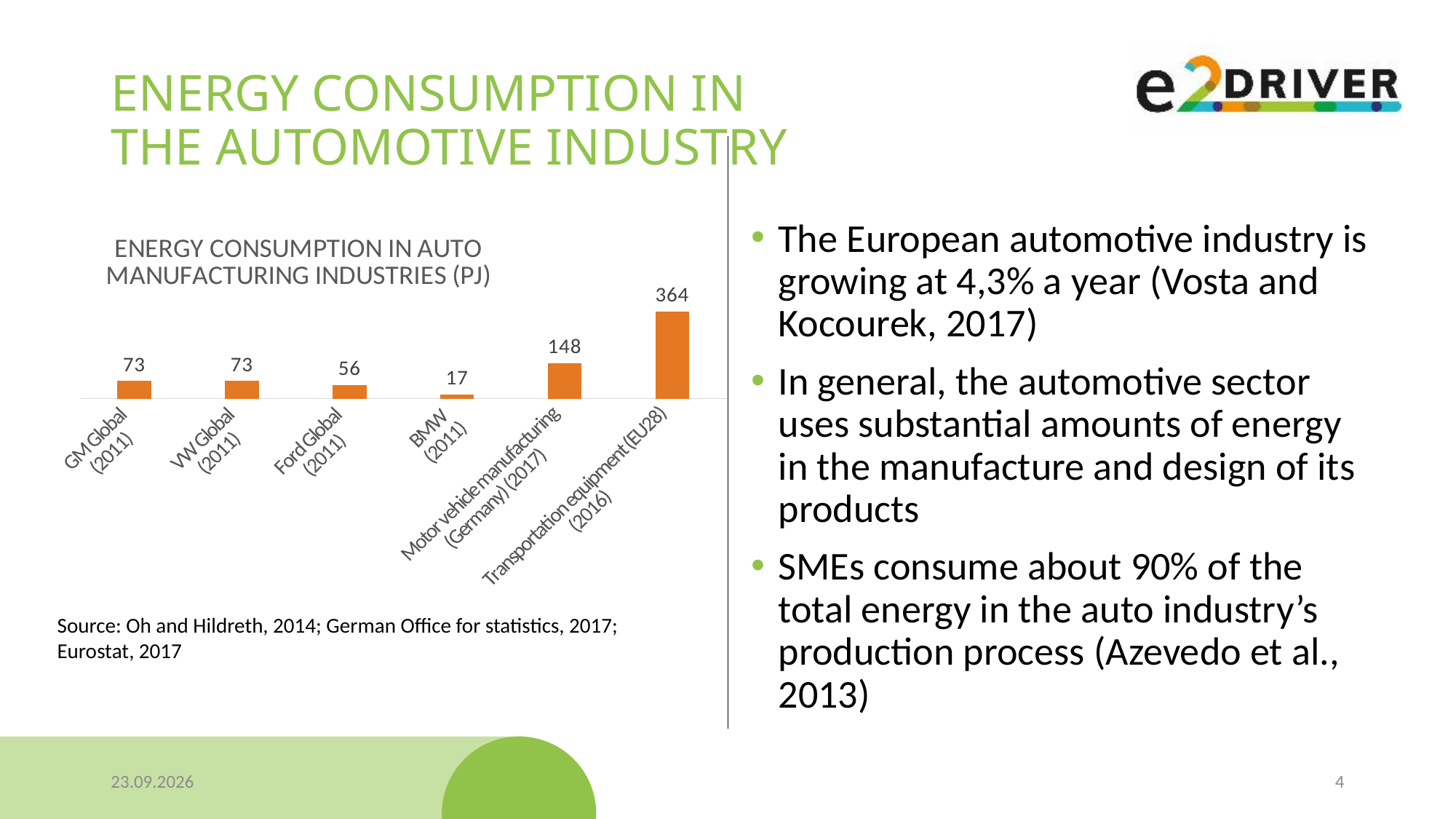
What is the energy consumption value for GM Global (2011)? 73 How many categories are shown in the chart? 6 What is the difference between the values for GM Global (2011) and Ford Global (2011)? 17 What is the difference between the values for Transportation equipment (EU28) (2016) and Motor vehicle manufacturing (Germany) (2017)? 216 Which category has the highest energy consumption? Transportation equipment (EU28) (2016) What is the energy consumption value for Ford Global (2011)? 56 Which is larger, the value for Ford Global (2011) or the value for BMW (2011)? Ford Global (2011) What kind of chart is shown on the slide? Bar chart Which category has the lowest energy consumption? BMW (2011) What is the energy consumption value for BMW (2011)? 17 What is the title of the chart? ENERGY CONSUMPTION IN AUTO MANUFACTURING INDUSTRIES (PJ) What is the value shown for Motor vehicle manufacturing (Germany) (2017)? 148